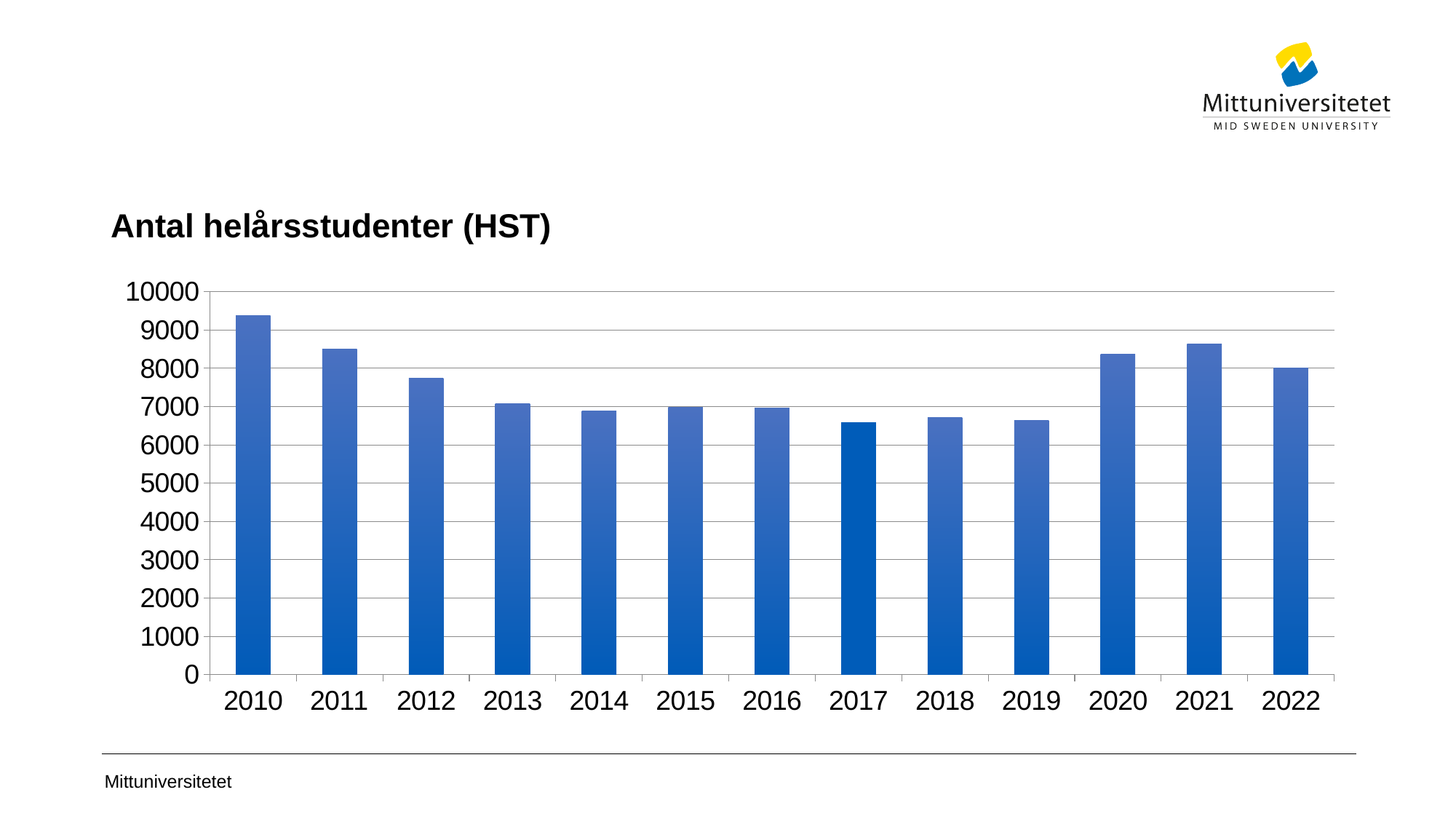
Is the value for 2019 greater or less than 7000? less Is the value for 2010 greater or less than 9000? greater Which year has the highest number of helårsstudenter? 2010 Which year has the larger value, 2010 or 2011? 2010 Is the value for 2017 greater or less than 7000? less What type of chart is shown on the slide? bar chart Which year has the larger value, 2020 or 2021? 2021 What is the title of the chart? Antal helårsstudenter (HST) How many years are shown on the x axis of the chart? 13 Do the values rise or fall from 2010 to 2013? fall